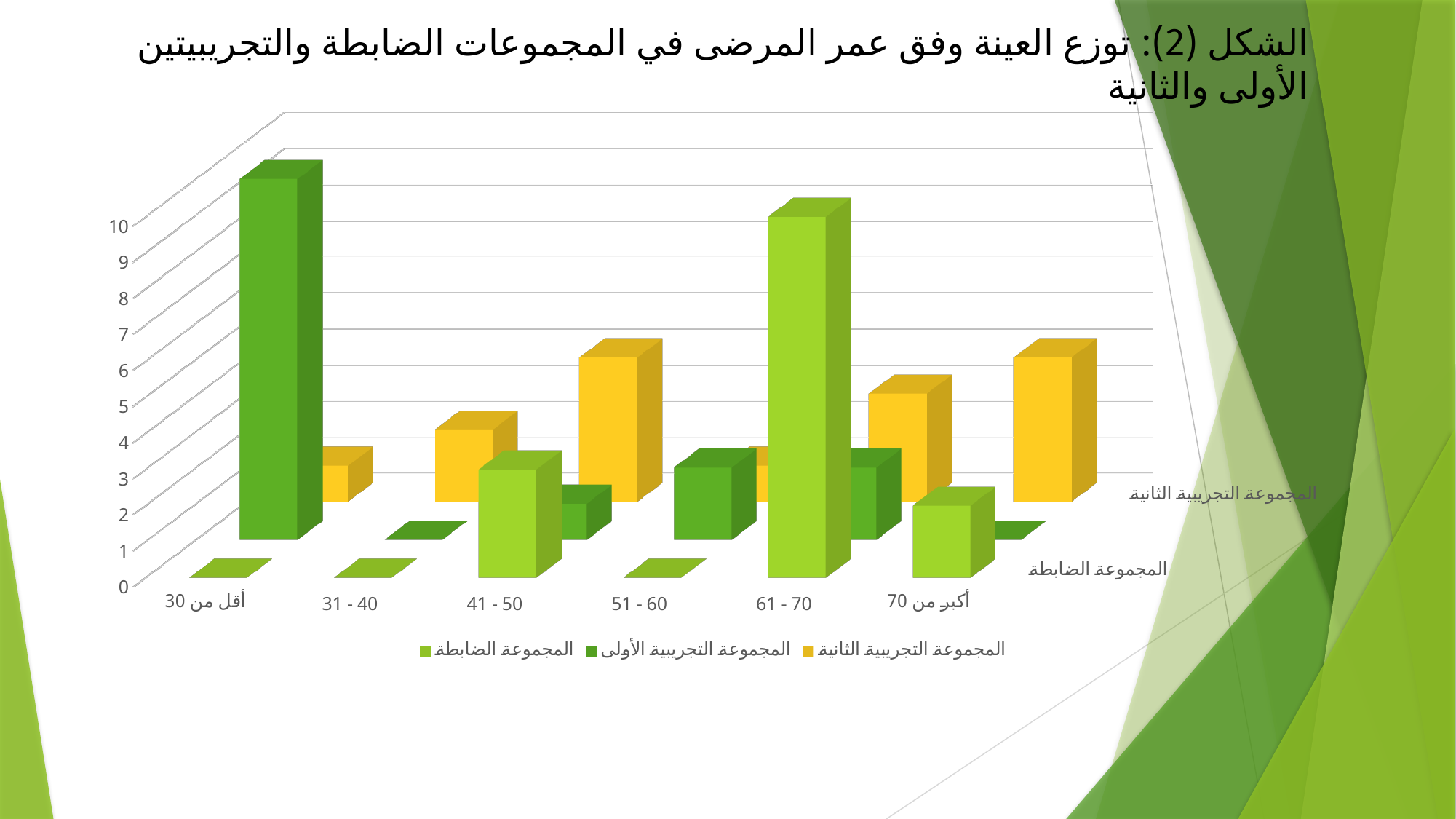
For المجموعة التجريبية الأولى, which is larger: the value for أقل من 30 or the value for 41 - 50? أقل من 30 How many series does the legend list? 3 Is the value for المجموعة الضابطة in the 61 - 70 category greater or less than 5? greater What kind of chart is shown on the slide? bar chart Which age category has the highest value for المجموعة التجريبية الأولى? أقل من 30 What is the highest value labelled on the vertical axis? 10 How many age categories are shown on the x axis? 6 Is the value for المجموعة الضابطة in the 41 - 50 category greater or less than 5? less For المجموعة الضابطة, which is larger: the value for 61 - 70 or the value for 41 - 50? 61 - 70 Is the value for المجموعة التجريبية الأولى in the أقل من 30 category greater or less than 5? greater Which age category has the highest value for المجموعة الضابطة? 61 - 70 Which series is shown in yellow in the legend? المجموعة التجريبية الثانية